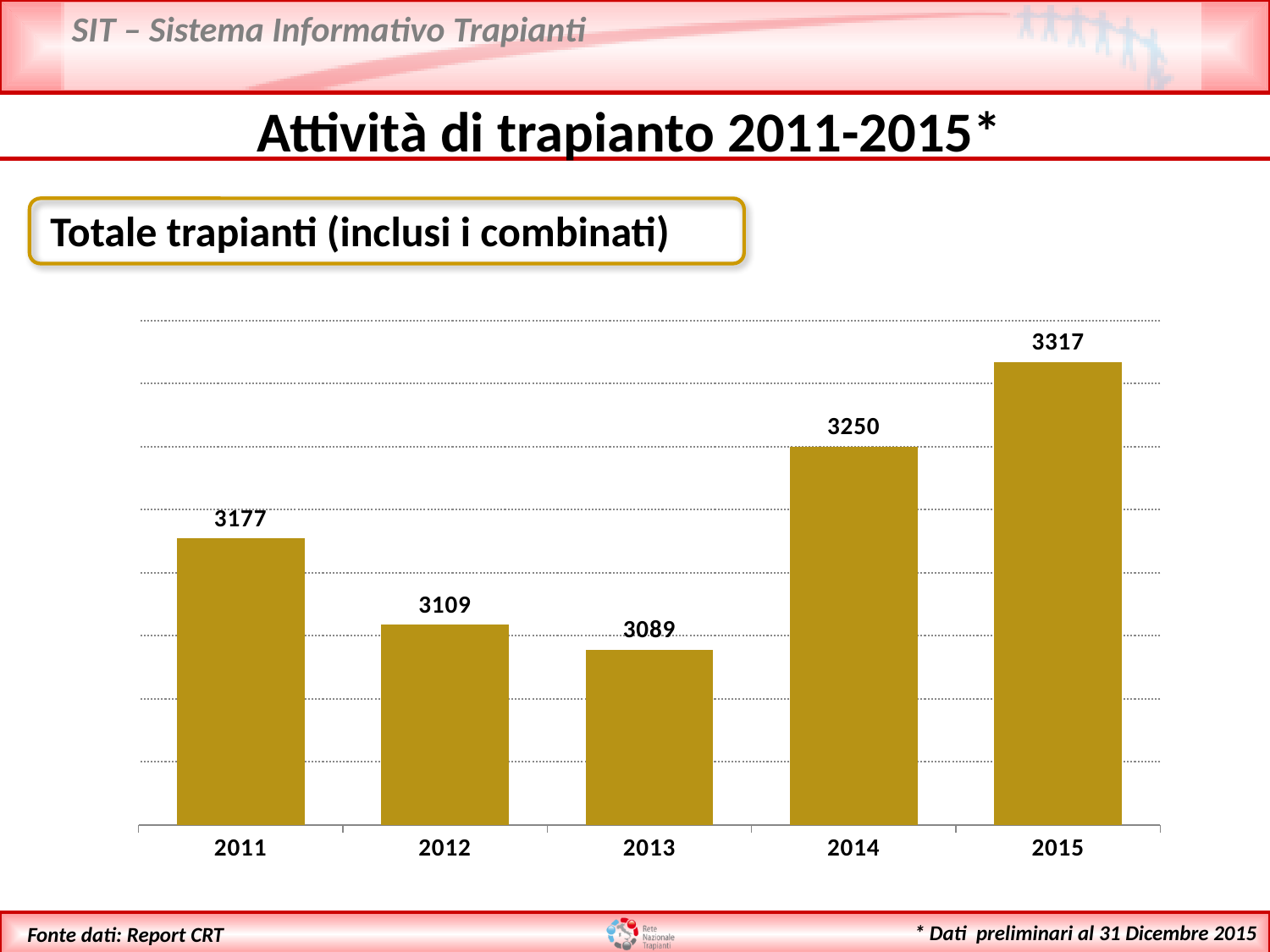
What is the title of the chart box above the bars? Totale trapianti (inclusi i combinati) What is the difference between the values for 2015 and 2014? 67 What is the value for 2015? 3317 Which is larger, the value for 2012 or the value for 2014? 2014 What kind of chart is shown on the slide? bar chart How many years are shown on the x axis? 5 What is the value for 2013? 3089 What is the difference between the values for 2011 and 2013? 88 Which year has the highest value? 2015 Which year has the lowest value? 2013 What is the value for 2011? 3177 Do the values rise or fall from 2013 to 2015? rise